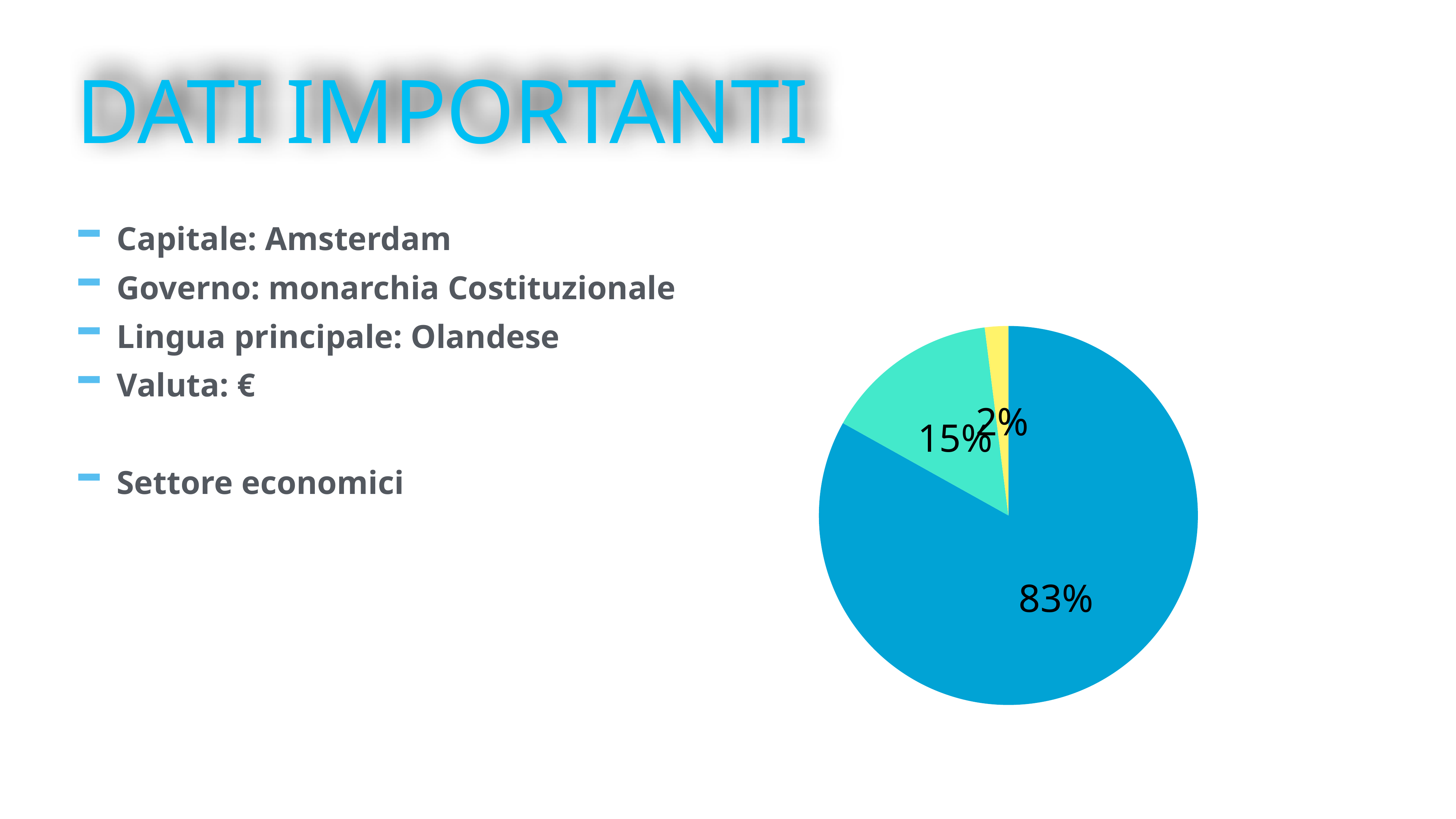
How many slices does the pie chart have? 3 Does the pie chart have a legend? No What percentage is shown on the green slice of the pie chart? 15% What percentage is shown on the blue slice of the pie chart? 83% What is the difference between the green slice and the yellow slice of the pie chart? 13% What percentage is shown on the smallest slice of the pie chart? 2% Which slice is larger in the pie chart, the green one or the yellow one? the green one What colour is the largest slice of the pie chart? blue What is the difference between the largest slice and the green slice of the pie chart? 68% What percentage is shown on the largest slice of the pie chart? 83% What kind of chart is shown on the slide? pie chart What percentage is shown on the yellow slice of the pie chart? 2%